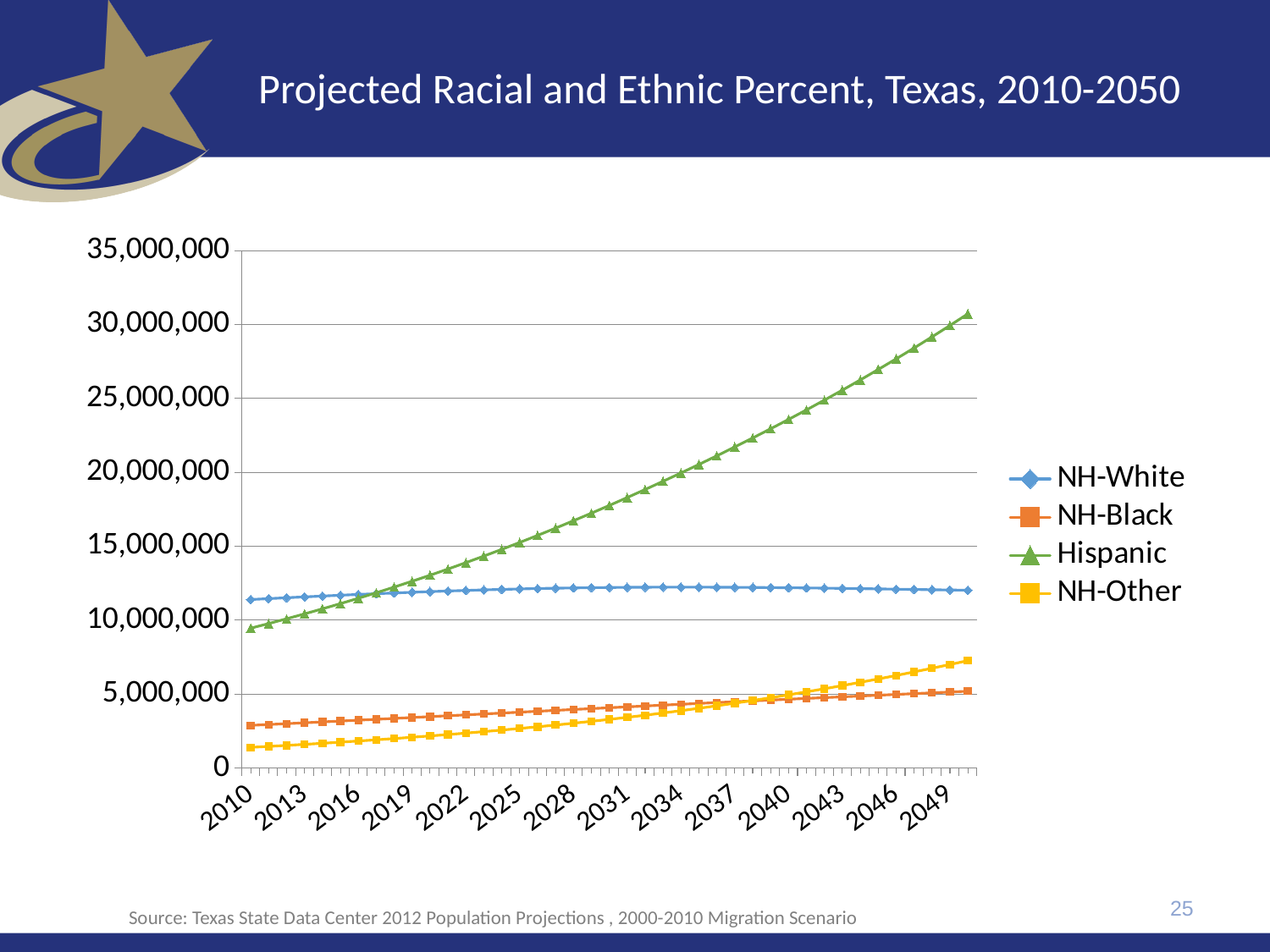
Which series has the highest value in 2050? Hispanic What is the title of the chart? Projected Racial and Ethnic Percent, Texas, 2010-2050 Is the NH-Black value in 2010 greater or less than 5,000,000? less Does the Hispanic series rise or fall from 2010 to 2050? rise Which series has the lowest value in 2010? NH-Other What kind of chart is shown on the slide? line chart Is the Hispanic value in 2050 greater or less than 30,000,000? greater Is the Hispanic value in 2010 greater or less than 10,000,000? less How many series does the legend list? 4 In 2050, which is larger, NH-White or Hispanic? Hispanic In 2010, which is larger, NH-White or Hispanic? NH-White